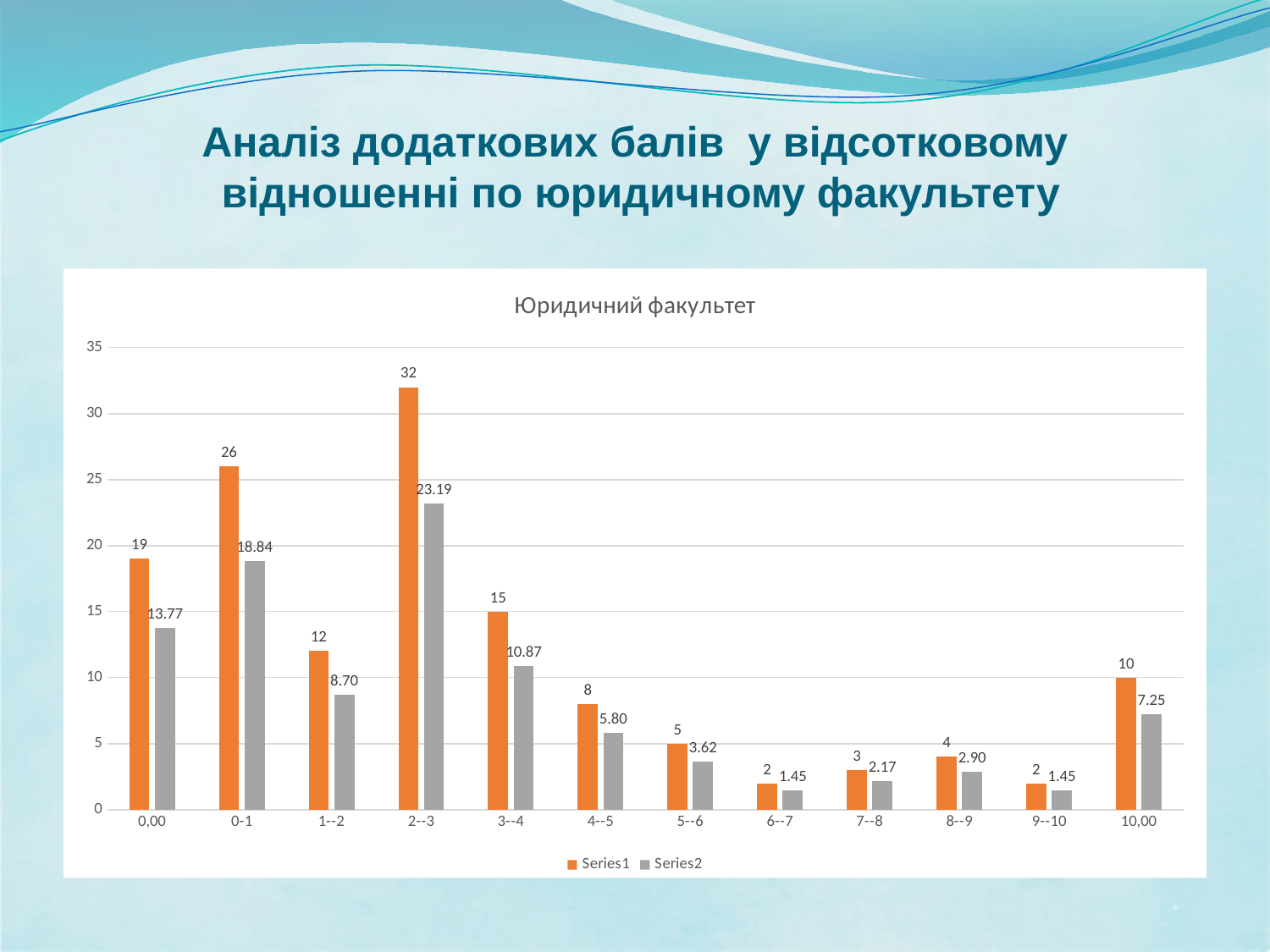
Which category has the lowest Series2 value? 6--7 and 9--10 (both 1.45) How many series does the legend list? 2 What kind of chart is shown on the slide? bar chart Is the Series1 value for 2--3 greater or less than 30? greater Which is larger: the Series2 value for 3--4 or the Series2 value for 1--2? 3--4 How many categories are shown on the x axis? 12 What is the Series2 value for the category 10,00? 7.25 What is the Series1 value for the category 2--3? 32 Which category has the highest Series1 value? 2--3 What is the Series2 value for the category 0-1? 18.84 What is the difference between the Series1 values for 0-1 and 0,00? 7 What is the title of the chart? Юридичний факультет